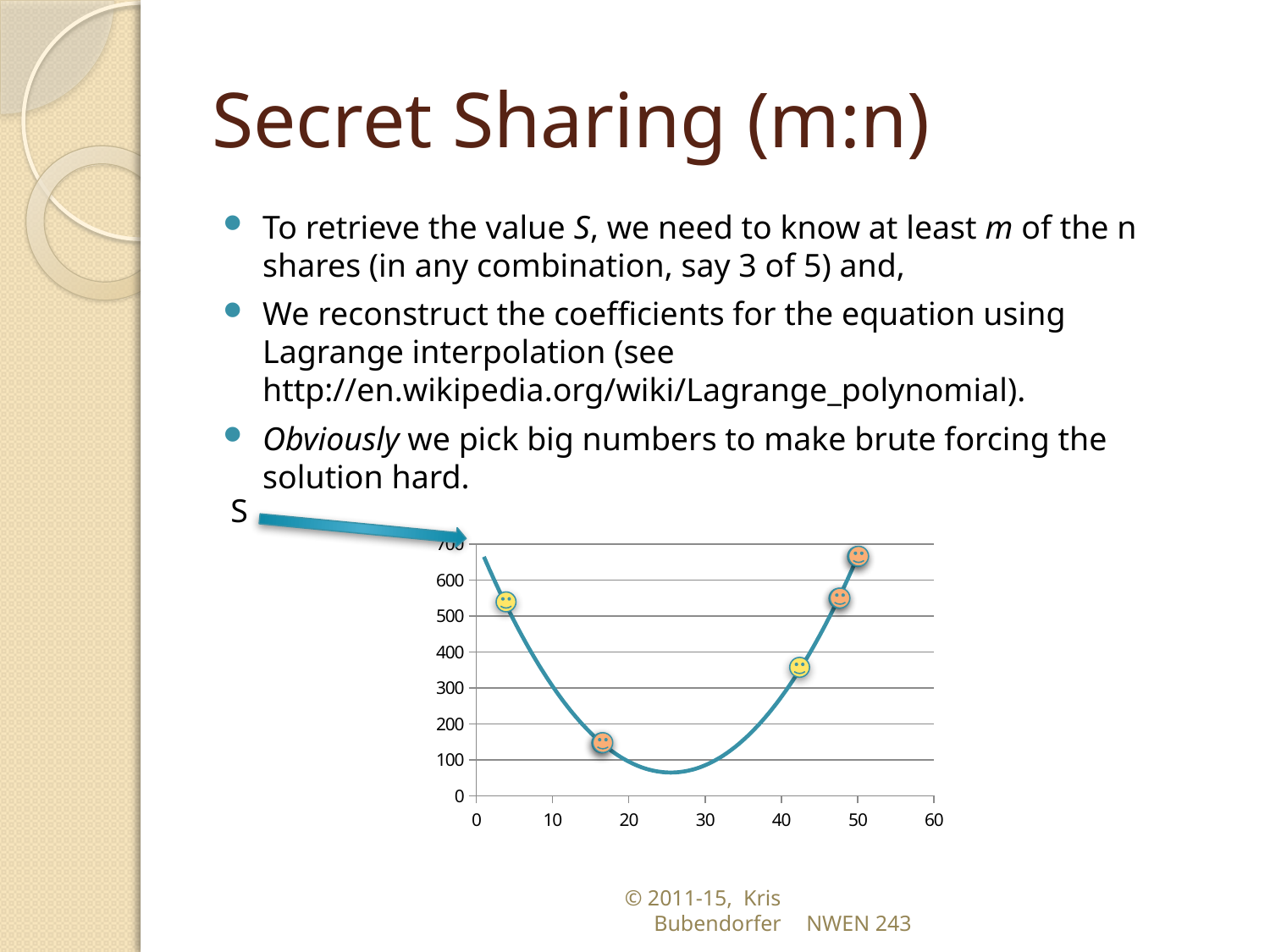
Is the value of the marked point near x = 42 greater or less than 300? greater What is the highest value shown on the x axis? 60 Which marked point is higher: the one near x = 16 or the one near x = 50? the one near x = 50 Is the lowest point of the curve greater or less than 100? less What is the highest value shown on the y axis? 700 Which marked point has the lowest value? the one near x = 16 Is the value of the marked point near x = 16 greater or less than 200? less How many smiley-face points are marked on the curve? 5 Does the curve fall or rise as x increases from 0 to 20? fall What kind of chart is shown on the slide? line chart Does the curve fall or rise as x increases from 30 to 60? rise